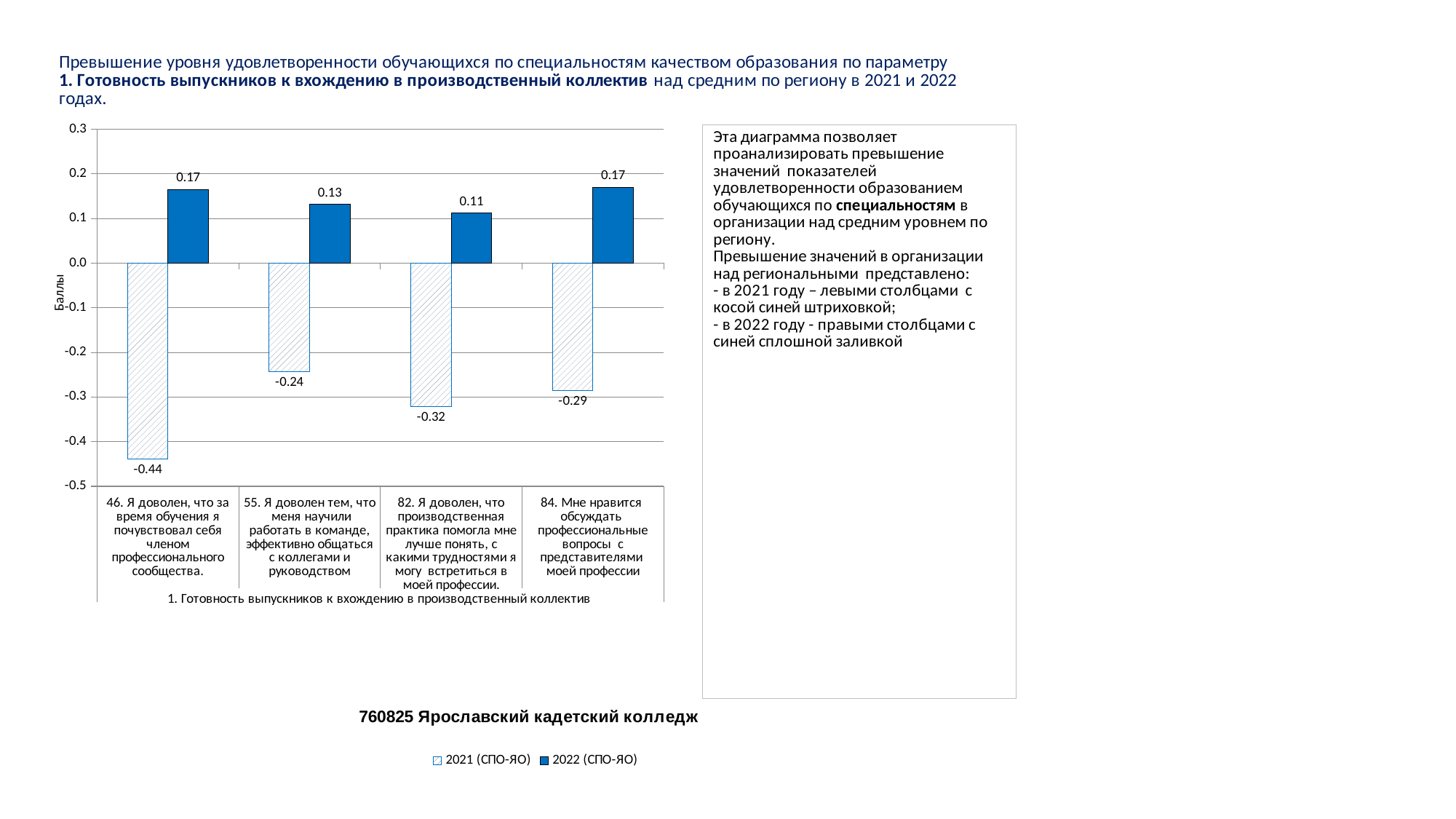
What is the 2022 (СПО-ЯО) value for category 84 ("Мне нравится обсуждать профессиональные вопросы...")? 0.17 What is the label of the vertical axis of the chart? Баллы How many categories are shown on the x axis of the chart? 4 What is the 2022 (СПО-ЯО) value for category 55 ("Я доволен тем, что меня научили работать в команде...")? 0.13 How many series does the chart legend list? 2 What is the difference between the 2022 and 2021 values for category 46? 0.61 What is the 2021 (СПО-ЯО) value for category 82 ("Я доволен, что производственная практика помогла мне лучше понять...")? -0.32 Which category has the lowest 2021 (СПО-ЯО) value? 46. Я доволен, что за время обучения я почувствовал себя членом профессионального сообщества. Which category has the lowest 2022 (СПО-ЯО) value? 82. Я доволен, что производственная практика помогла мне лучше понять, с какими трудностями я могу встретиться в моей профессии. What is the 2021 (СПО-ЯО) value for category 46 ("Я доволен, что за время обучения я почувствовал себя членом профессионального сообщества")? -0.44 Which is larger for category 55: the 2021 (СПО-ЯО) value or the 2022 (СПО-ЯО) value? 2022 (СПО-ЯО) What type of chart is shown on the slide? Bar chart